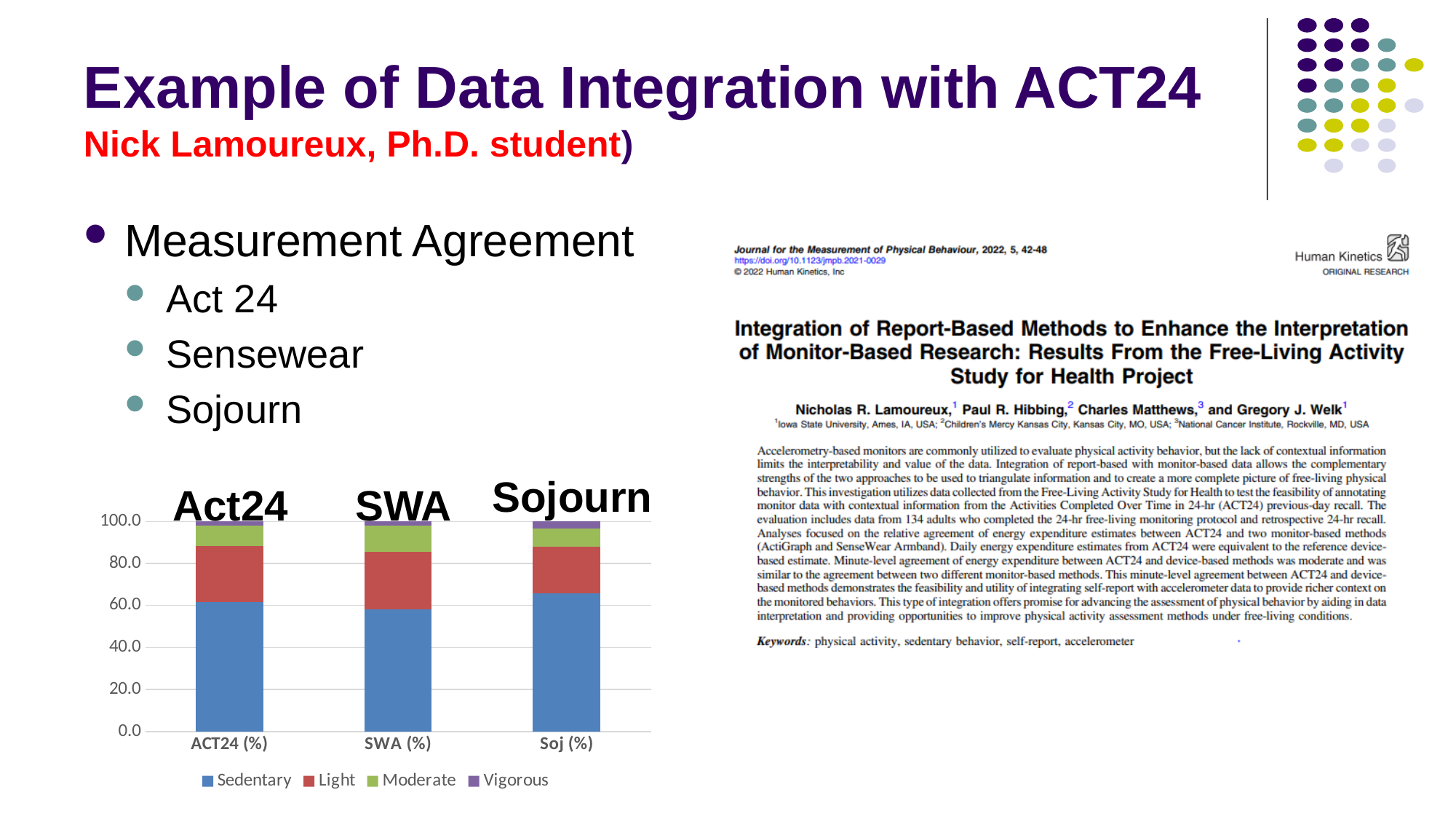
Which series are listed in the chart's legend? Sedentary, Light, Moderate, Vigorous Which is larger, the Sedentary segment for Soj (%) or for SWA (%)? Soj (%) Is the Sedentary value for SWA (%) greater or less than 80? less What colour represents the Sedentary series in the chart? Blue Is the Sedentary value for Soj (%) greater or less than 60? greater Which category has the smallest Sedentary segment? SWA (%) Which is larger, the Sedentary segment or the Light segment for ACT24 (%)? Sedentary How many series does the chart's legend list? 4 Which category has the largest Sedentary segment? Soj (%) Is the Sedentary value for ACT24 (%) greater or less than 40? greater How many categories (bars) are shown on the x axis of the chart? 3 What kind of chart is shown on the slide? Stacked bar chart